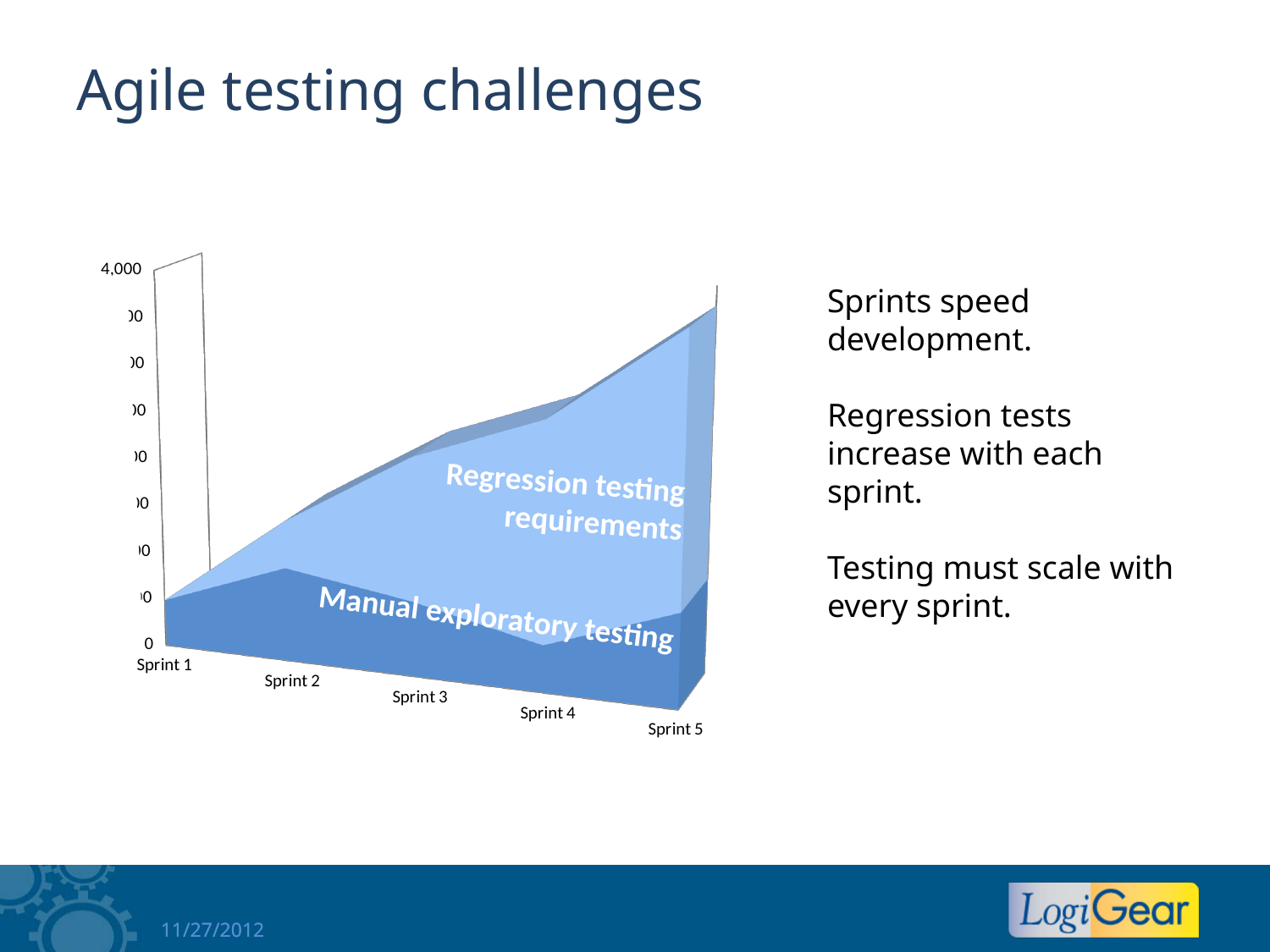
Which series is stacked on top in the chart? Regression testing requirements What are the names of the two series plotted in the chart? Manual exploratory testing; Regression testing requirements How many sprints are shown along the x axis of the chart? 5 How many series are plotted in the chart? 2 What kind of chart is shown on the slide? Area chart At which sprint is the Regression testing requirements value lowest? Sprint 1 At which sprint is the Regression testing requirements value highest? Sprint 5 What is the label of the last category on the x axis? Sprint 5 What is the highest value labelled on the vertical axis of the chart? 4,000 Does the Regression testing requirements series rise or fall from Sprint 1 to Sprint 5? Rise Is the Regression testing requirements value larger at Sprint 5 or at Sprint 2? Sprint 5 What is the label of the first category on the x axis? Sprint 1